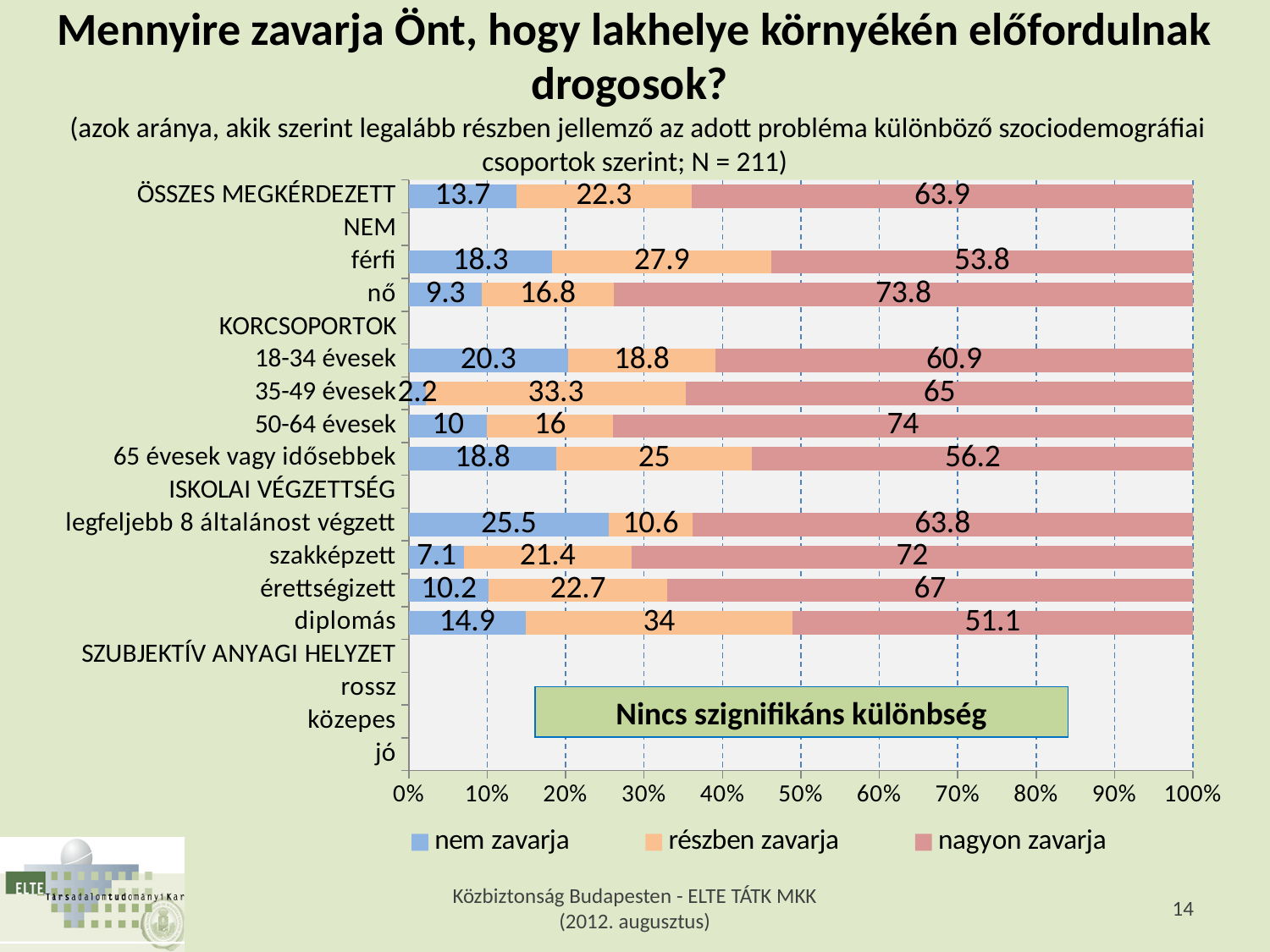
What is the difference between the 'nagyon zavarja' values for nő and férfi? 20 What text is shown in the box over the SZUBJEKTÍV ANYAGI HELYZET rows? Nincs szignifikáns különbség Which category has the lowest 'nem zavarja' value? 35-49 évesek What is the 'nagyon zavarja' value for szakképzett? 72 What is the 'nem zavarja' value for férfi? 18.3 What is the 'részben zavarja' value for diplomás? 34 Which category has the lowest 'részben zavarja' value? legfeljebb 8 általánost végzett Which category has the highest 'nem zavarja' value? legfeljebb 8 általánost végzett What type of chart is shown on the slide? stacked bar chart What is the 'nagyon zavarja' value for ÖSSZES MEGKÉRDEZETT? 63.9 Which is larger: the 'részben zavarja' value for diplomás or for szakképzett? diplomás How many series does the legend list? 3